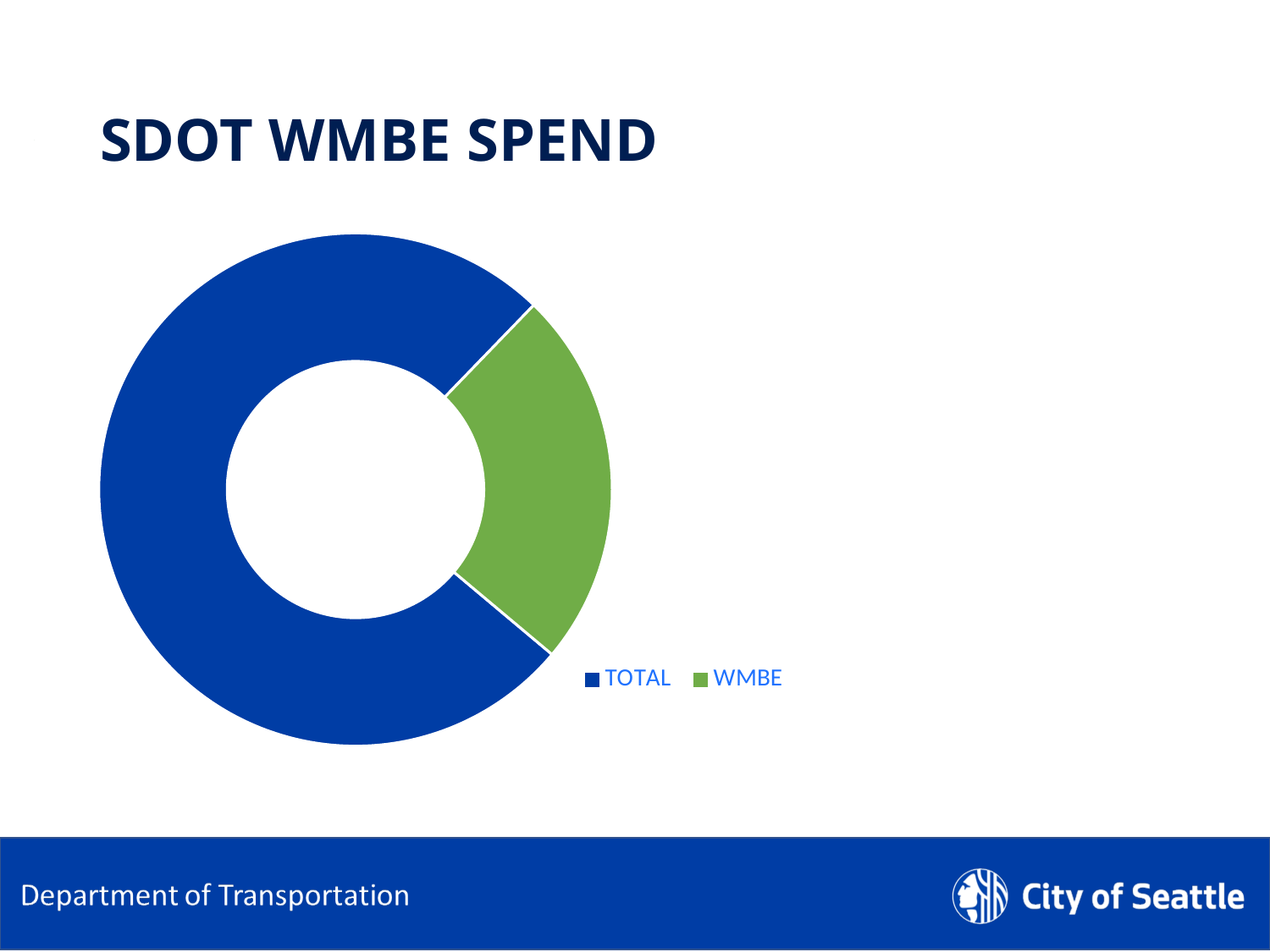
Which slice is larger, TOTAL or WMBE? TOTAL How many categories does the chart show? 2 What are the two entries listed in the chart's legend? TOTAL and WMBE Which category has the smallest slice of the chart? WMBE What is the title of the chart on the slide? SDOT WMBE SPEND What kind of chart is shown on the slide? doughnut chart Which category has the largest slice of the chart? TOTAL Is the WMBE slice larger or smaller than the TOTAL slice? smaller